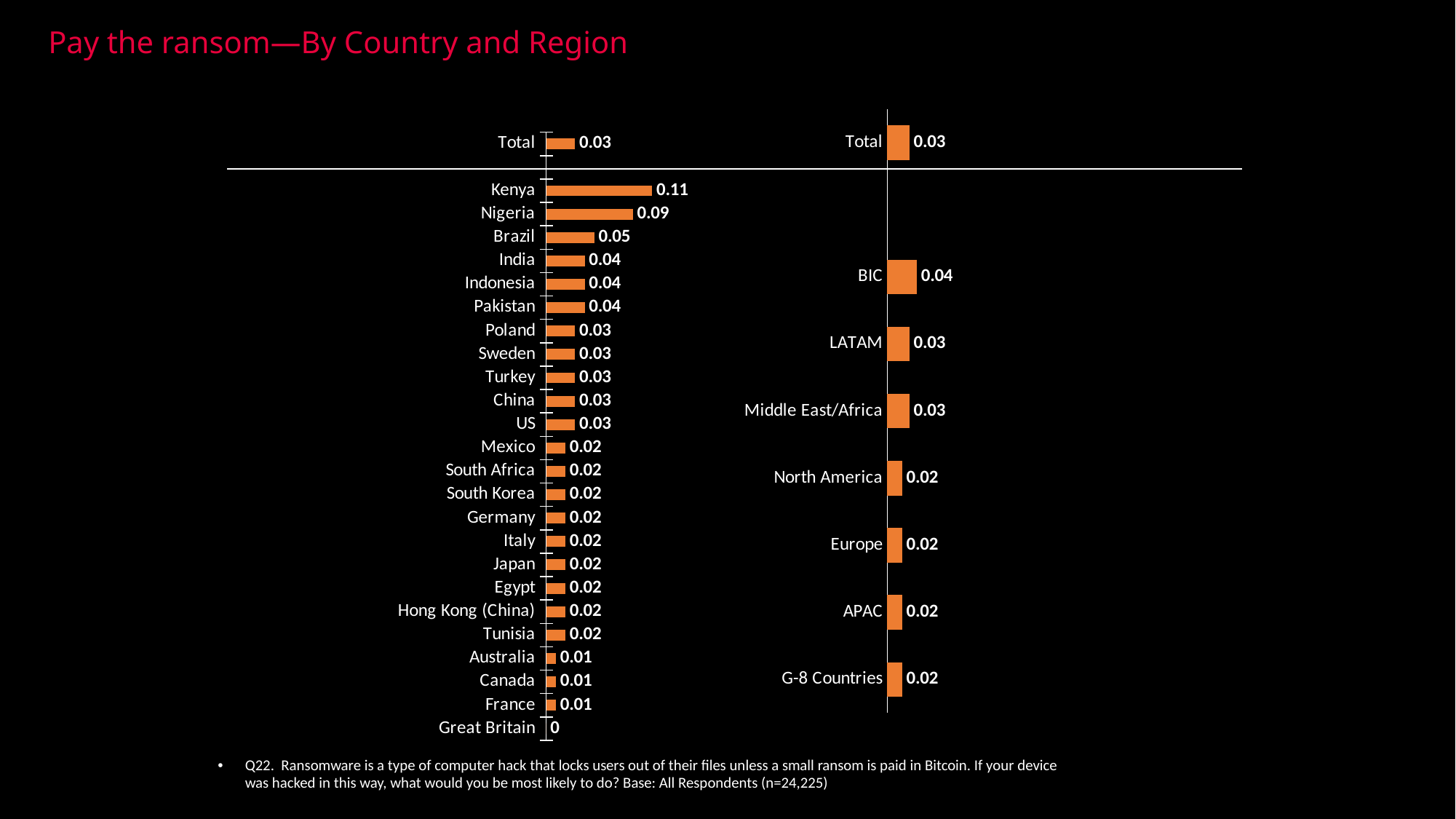
In the left chart (by country), which country has the lowest value? Great Britain In the left chart (by country), which is larger, the value for Brazil or the value for India? Brazil In the left chart (by country), what is the value for Kenya? 0.11 In the left chart (by country), what is the value for France? 0.01 In the right chart (by region), which region has the highest value? BIC In the right chart (by region), how many bars are plotted, including Total? 8 In the left chart (by country), what is the value for Brazil? 0.05 In the left chart (by country), which country has the highest value? Kenya In the right chart (by region), what is the value for North America? 0.02 What kind of chart is the left chart (by country)? Bar chart In the right chart (by region), what is the value for BIC? 0.04 In the left chart (by country), what is the difference between the values for Kenya and Nigeria? 0.02